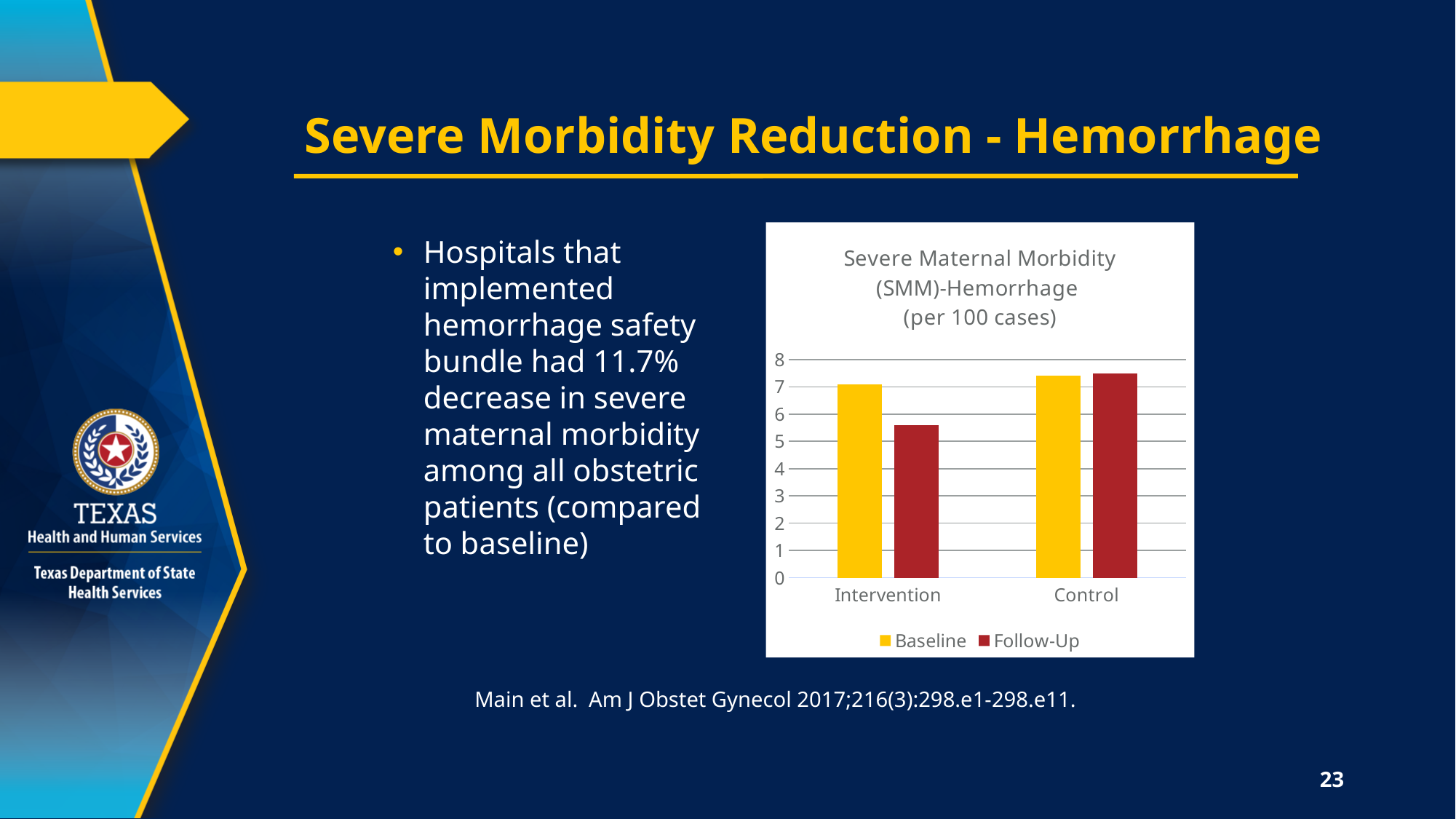
Which bar is the lowest in the chart? Intervention Follow-Up Which Follow-Up value is larger: Intervention or Control? Control What kind of chart is shown on the slide? bar chart How many categories are shown on the x axis? 2 Is the Baseline value for Intervention greater or less than 6? greater What are the two series named in the legend? Baseline and Follow-Up Is the Follow-Up value for Control greater or less than 8? less What is the title of the chart? Severe Maternal Morbidity (SMM)-Hemorrhage (per 100 cases) Is the Follow-Up value for Intervention greater or less than 6? less For the Intervention group, which is larger: the Baseline value or the Follow-Up value? Baseline How many series does the chart legend list? 2